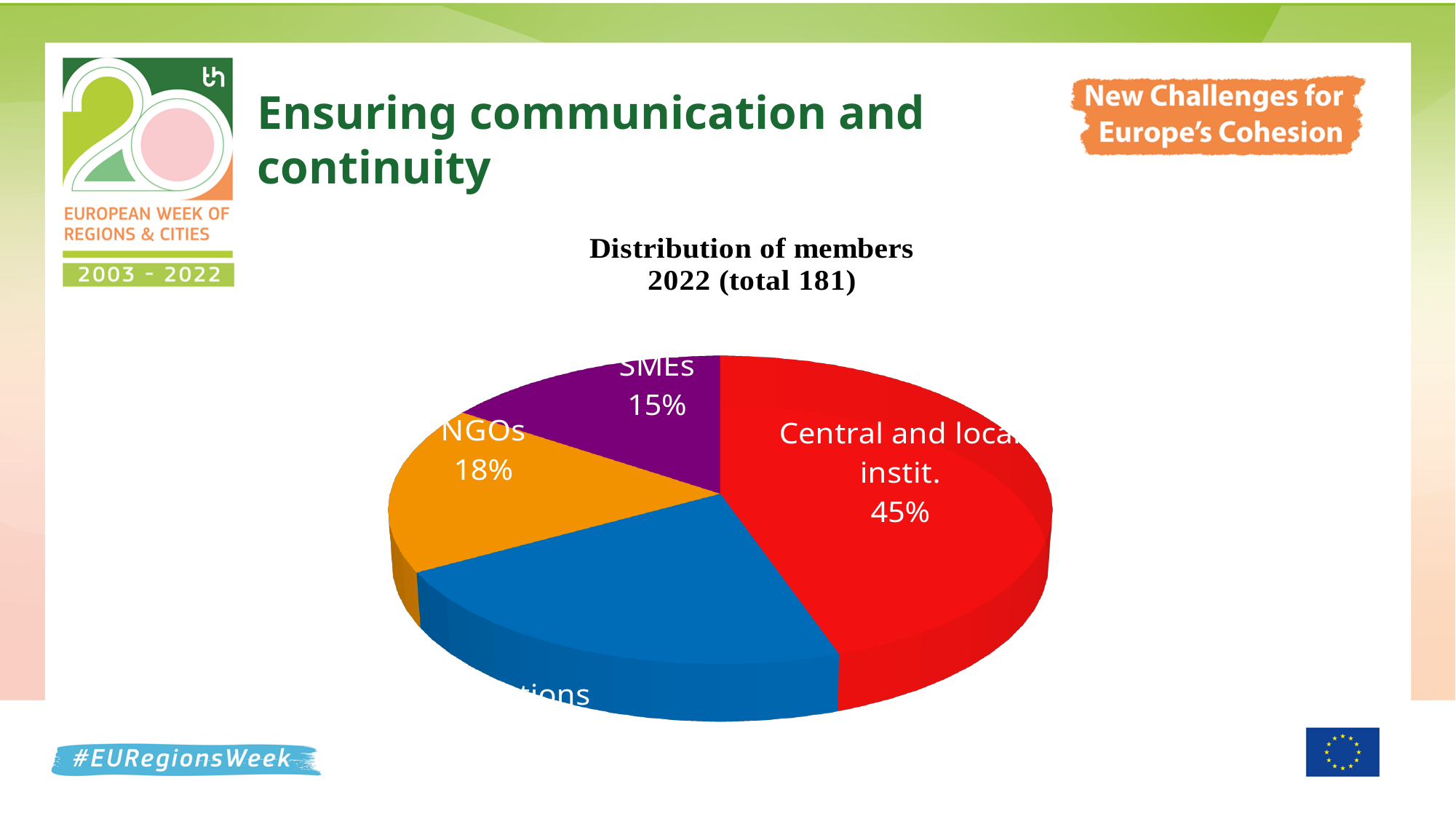
Which category has the largest share of the pie? Central and local instit. What share of members is SMEs? 15% What kind of chart is shown on the slide? pie chart How many percentage points larger is the Central and local instit. share than the NGOs share? 27 Which category has the smallest share of the pie? SMEs What is the title of the chart? Distribution of members 2022 (total 181) Which has a larger share, NGOs or SMEs? NGOs How many percentage points larger is the NGOs share than the SMEs share? 3 What share of members is Central and local instit.? 45% What share of members is NGOs? 18% How many slices does the pie chart have? 4 What colour is the Central and local instit. slice? red